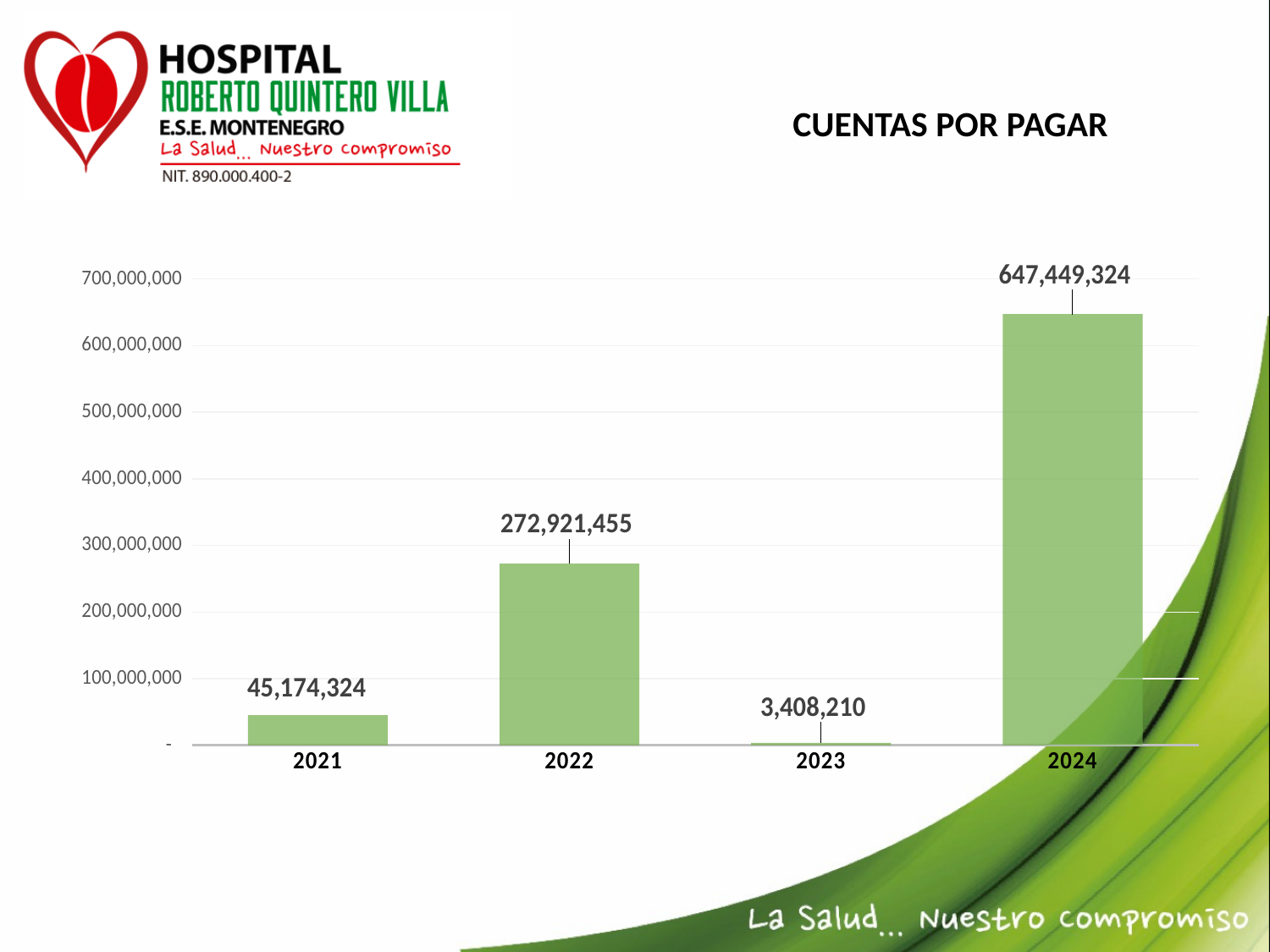
What is the value for 2022 in the CUENTAS POR PAGAR chart? 272,921,455 How many years are shown in the CUENTAS POR PAGAR chart? 4 What is the value for 2021 in the CUENTAS POR PAGAR chart? 45,174,324 Is the value for 2022 in the CUENTAS POR PAGAR chart greater or less than 300,000,000? less What is the difference between the values for 2024 and 2022 in the CUENTAS POR PAGAR chart? 374,527,869 What is the value for 2024 in the CUENTAS POR PAGAR chart? 647,449,324 What kind of chart is shown on the slide? bar chart What is the difference between the values for 2022 and 2021 in the CUENTAS POR PAGAR chart? 227,747,131 Which year has the highest value in the CUENTAS POR PAGAR chart? 2024 What is the value for 2023 in the CUENTAS POR PAGAR chart? 3,408,210 Which year has the lowest value in the CUENTAS POR PAGAR chart? 2023 Which is larger in the CUENTAS POR PAGAR chart, the value for 2021 or the value for 2023? 2021